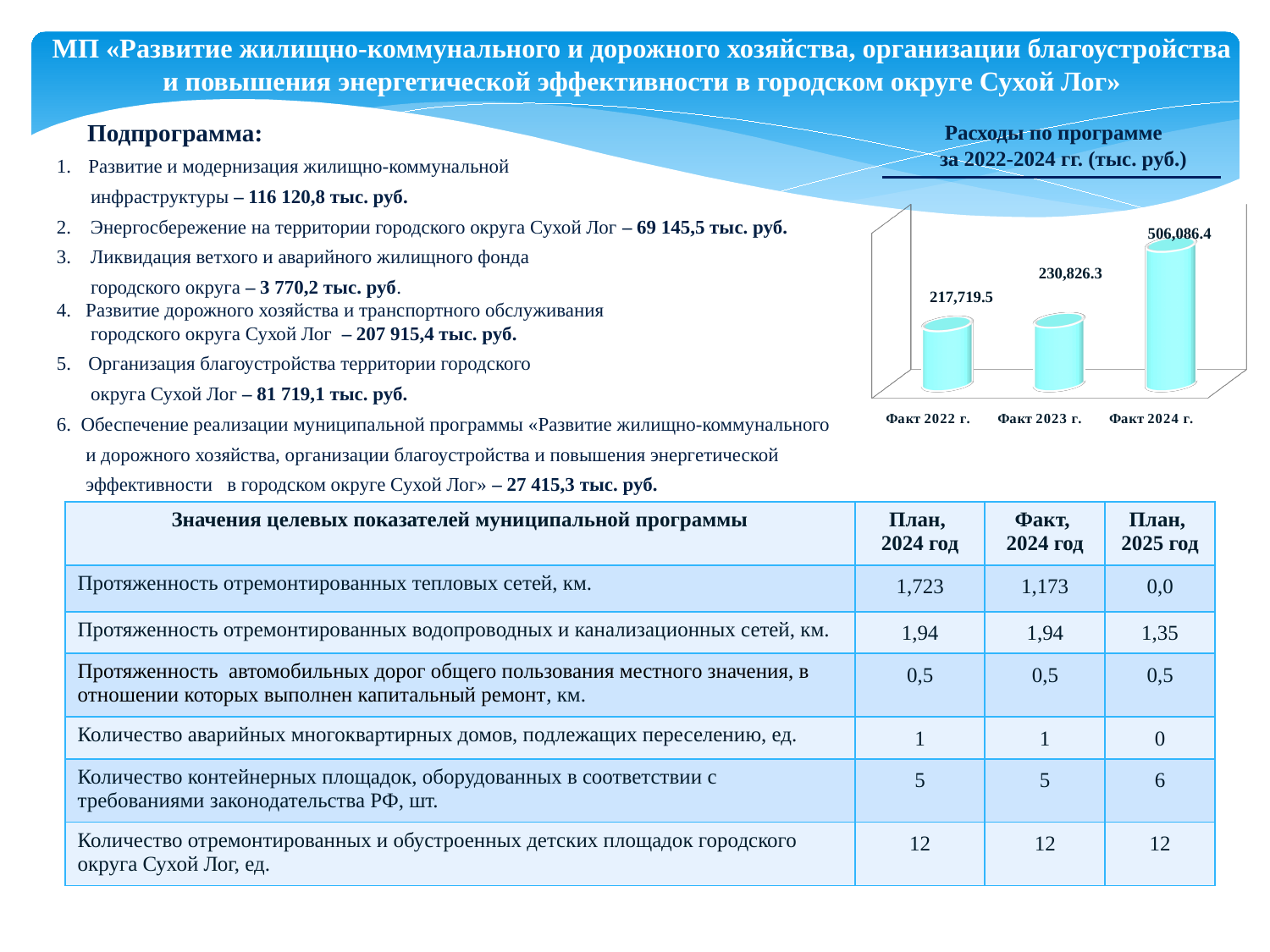
What is the value for Факт 2023 г. in the chart «Расходы по программе за 2022-2024 гг. (тыс. руб.)»? 230,826.3 Which category has the lowest value in the chart «Расходы по программе за 2022-2024 гг. (тыс. руб.)»? Факт 2022 г. What kind of chart is «Расходы по программе за 2022-2024 гг. (тыс. руб.)»? Bar chart Which category has the highest value in the chart «Расходы по программе за 2022-2024 гг. (тыс. руб.)»? Факт 2024 г. What is the title of the chart on the right side of the slide? Расходы по программе за 2022-2024 гг. (тыс. руб.) Do the values in the chart «Расходы по программе за 2022-2024 гг. (тыс. руб.)» rise or fall from Факт 2022 г. to Факт 2024 г.? Rise In the chart «Расходы по программе за 2022-2024 гг. (тыс. руб.)», what is the difference between the values for Факт 2024 г. and Факт 2023 г.? 275,260.1 In the chart «Расходы по программе за 2022-2024 гг. (тыс. руб.)», which is larger: the value for Факт 2024 г. or Факт 2022 г.? Факт 2024 г. In the chart «Расходы по программе за 2022-2024 гг. (тыс. руб.)», what is the difference between the values for Факт 2023 г. and Факт 2022 г.? 13,106.8 How many categories are shown in the chart «Расходы по программе за 2022-2024 гг. (тыс. руб.)»? 3 What is the value for Факт 2024 г. in the chart «Расходы по программе за 2022-2024 гг. (тыс. руб.)»? 506,086.4 What is the value for Факт 2022 г. in the chart «Расходы по программе за 2022-2024 гг. (тыс. руб.)»? 217,719.5